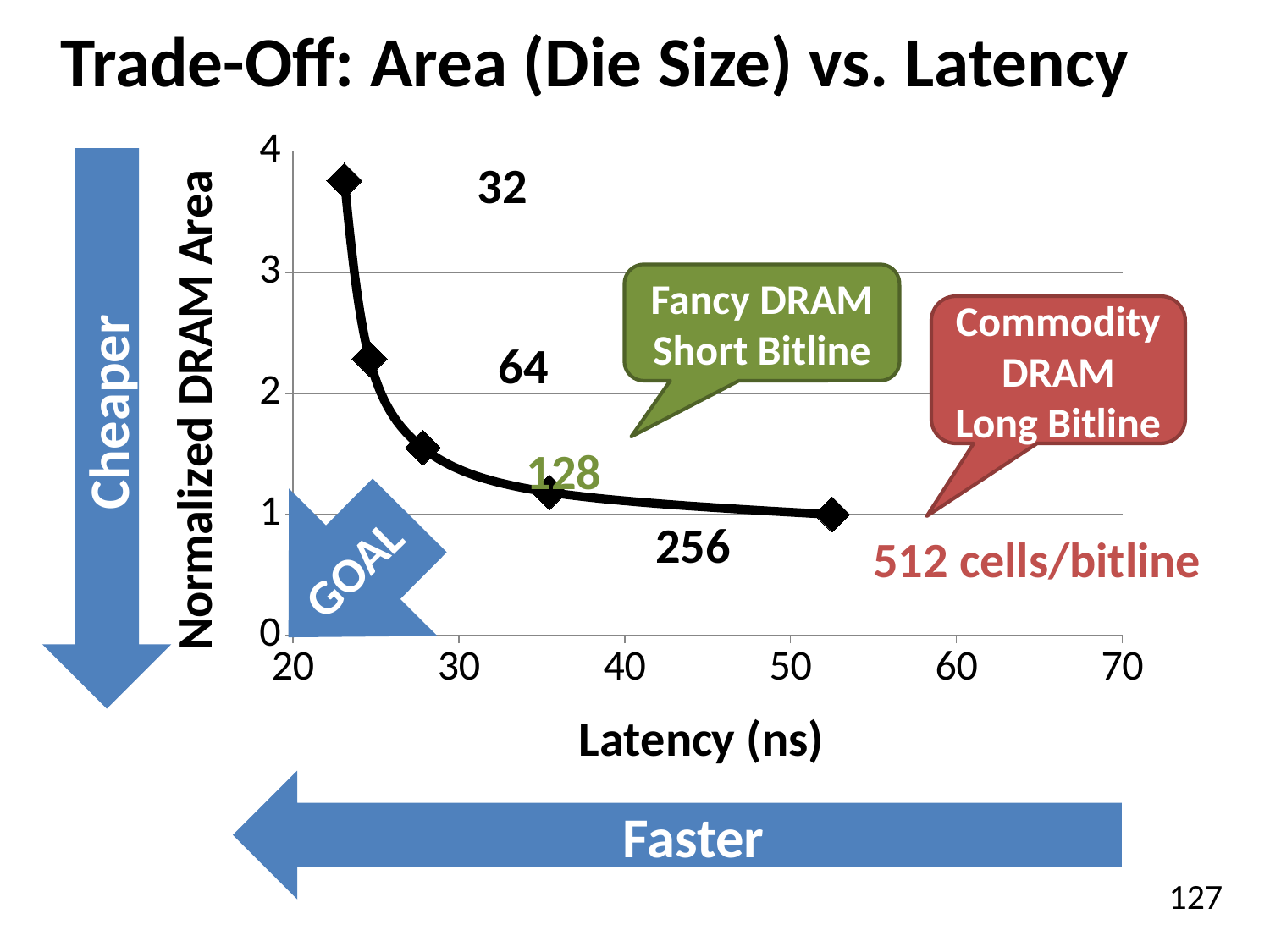
How many data points are plotted on the chart? 5 Which has a larger Normalized DRAM Area, the 64 point or the 128 point? 64 Which data point has the highest Normalized DRAM Area? 32 What kind of chart is shown on the slide? line chart Is the Normalized DRAM Area for the 32 cells/bitline point greater or less than 3? greater What is the title of the chart on the slide? Trade-Off: Area (Die Size) vs. Latency What is the label of the x axis? Latency (ns) Is the Normalized DRAM Area for the 64 cells/bitline point greater or less than 2? greater Is the Normalized DRAM Area for the 128 cells/bitline point greater or less than 2? less As latency increases along the x axis, does the Normalized DRAM Area rise or fall? fall Which data point has the highest latency? 512 cells/bitline